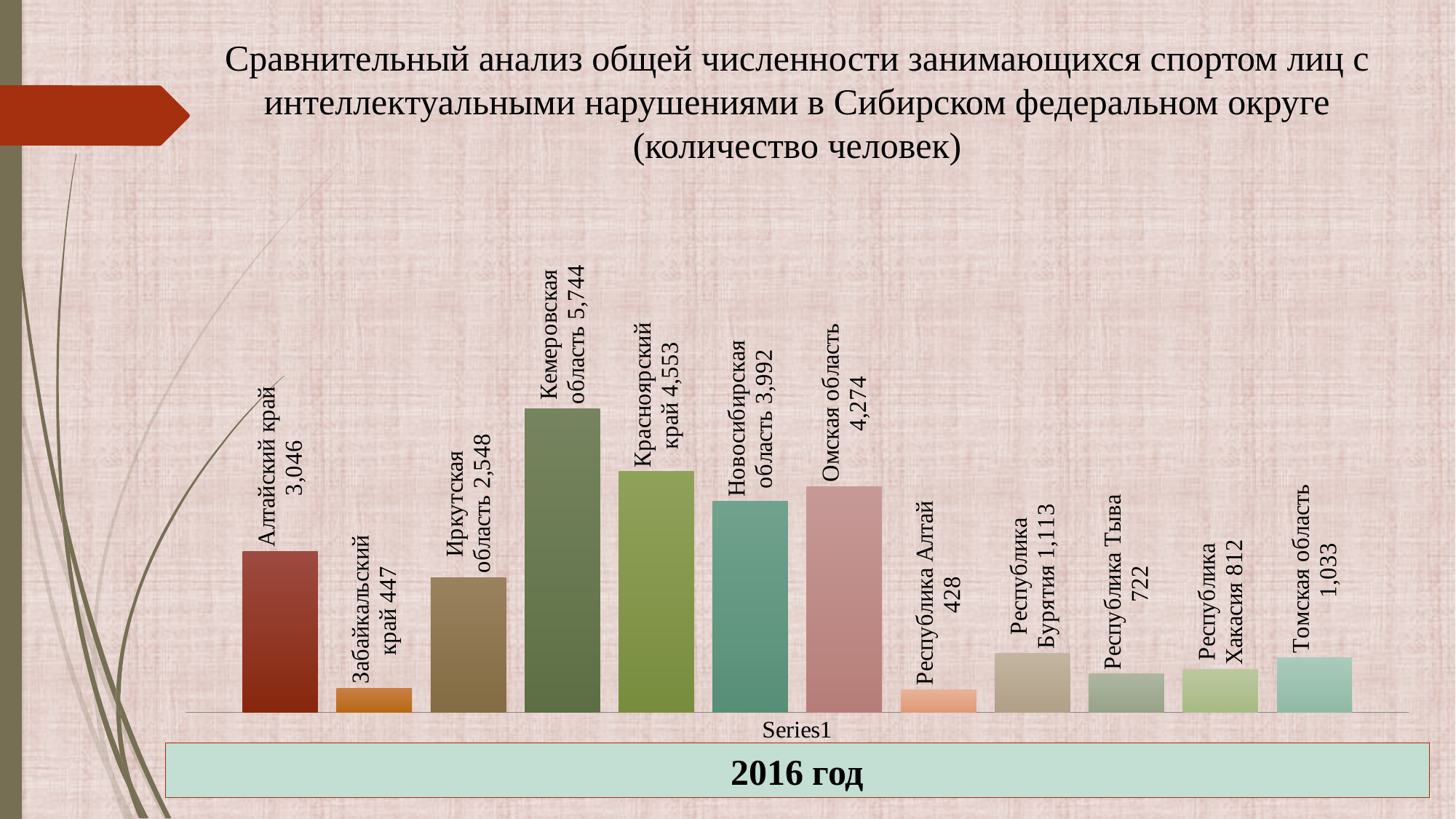
Which is larger, the value for Республика Тыва or the value for Республика Хакасия? Республика Хакасия How many regions (bars) are shown in the chart? 12 What is the difference between the values for Красноярский край and Омская область? 279 What type of chart is shown on the slide? bar chart What is the difference between the values for Алтайский край and Иркутская область? 498 Which is larger, the value for Новосибирская область or the value for Омская область? Омская область What is the value for Кемеровская область? 5,744 What year is indicated in the box below the chart? 2016 год Which region has the highest value in the chart? Кемеровская область What is the value for Республика Бурятия? 1,113 Which region has the lowest value in the chart? Республика Алтай What is the value for Томская область? 1,033